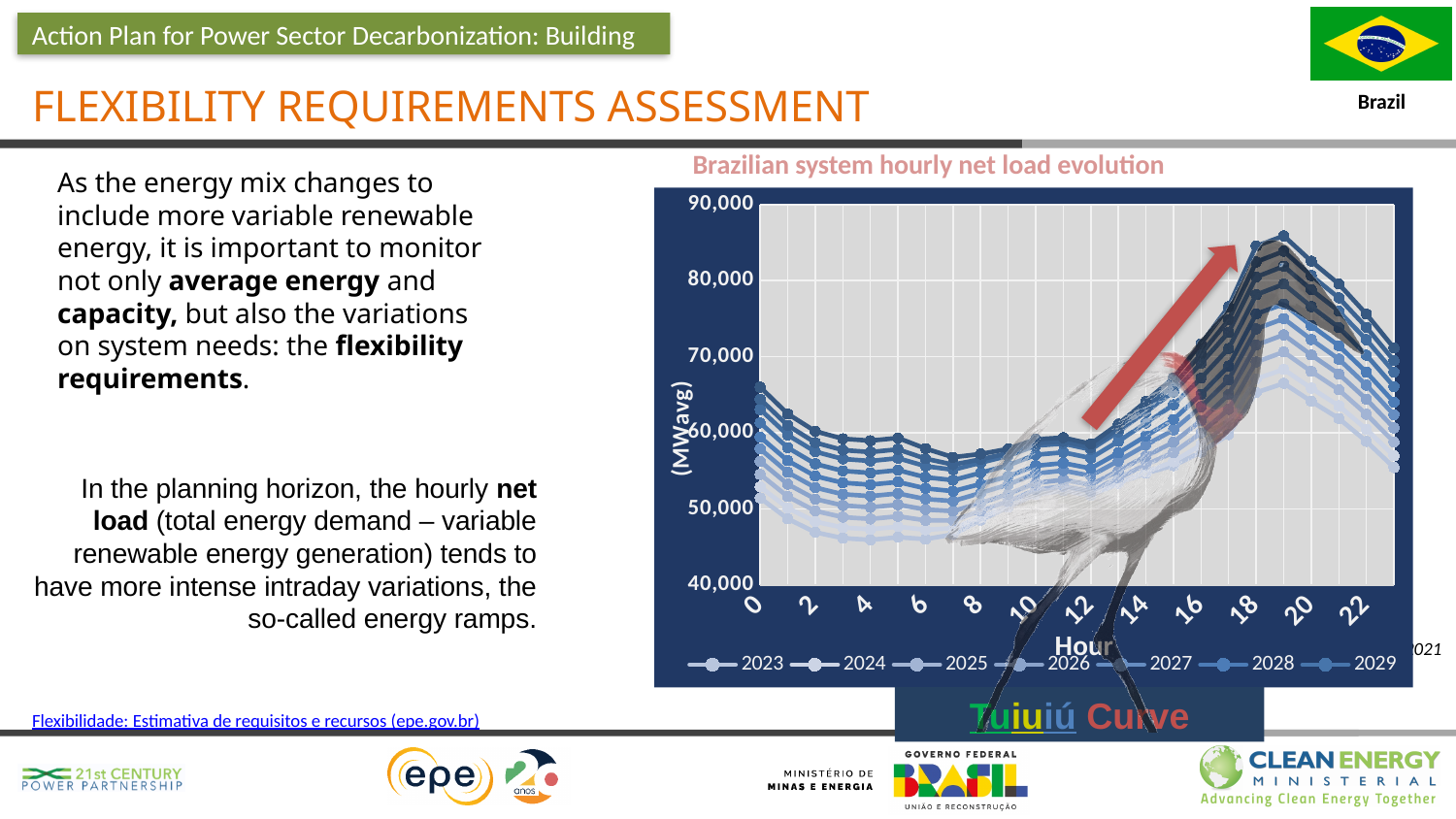
Is the value of the 2023 series at hour 18 greater or less than 80,000? less Is the value of the 2023 series at hour 8 greater or less than 50,000? less How many series does the legend of the net load chart list? 7 What kind of chart is shown on the slide? line chart What unit is shown on the y axis of the chart? MWavg How many hour labels are shown on the x axis of the chart? 12 Which year series has the lowest net load values on the chart? 2023 At hour 18, which series has the larger net load, 2023 or 2029? 2029 What is the title of the chart on the slide? Brazilian system hourly net load evolution Between hour 8 and hour 18, do the net load values rise or fall? rise